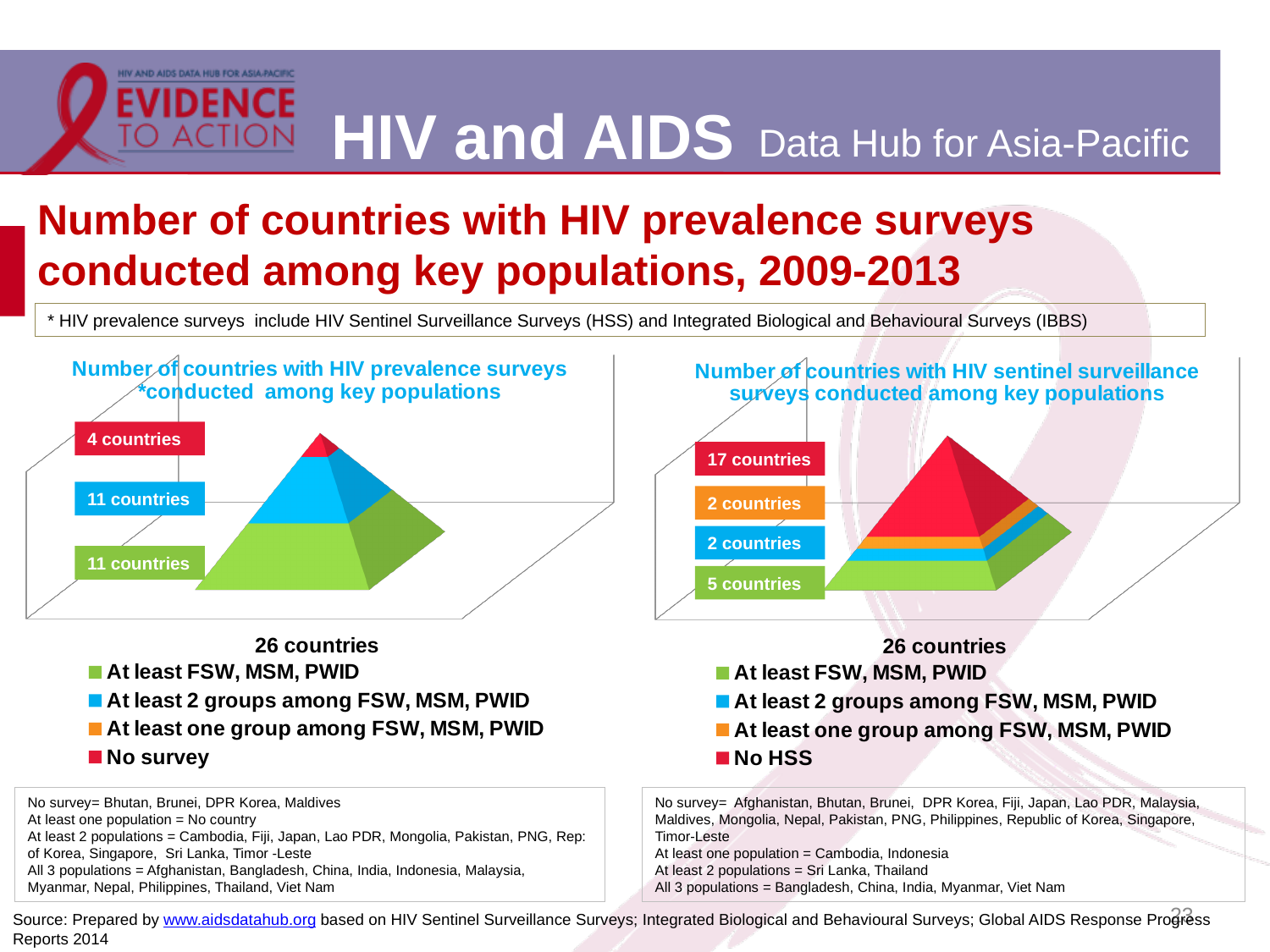
In the left chart (HIV prevalence surveys), which category has the smallest number of countries among those labelled? No survey What is the total number of countries shown in the left chart (HIV prevalence surveys)? 26 countries In the left chart (HIV prevalence surveys), how many countries have surveys for at least FSW, MSM, PWID? 11 countries In the right chart (HIV sentinel surveillance surveys), how many countries have surveys for at least one group among FSW, MSM, PWID? 2 countries In the left chart (HIV prevalence surveys), how many countries have no survey? 4 countries In the right chart (HIV sentinel surveillance surveys), what is the difference between the number of countries with no HSS and the number with surveys for at least FSW, MSM, PWID? 12 In the right chart (HIV sentinel surveillance surveys), how many countries have surveys for at least FSW, MSM, PWID? 5 countries In the right chart (HIV sentinel surveillance surveys), how many countries have no HSS? 17 countries How many entries does the legend of the right chart (HIV sentinel surveillance surveys) list? 4 Which is larger: the number of countries with no survey in the left chart or the number with no HSS in the right chart? No HSS in the right chart In the right chart (HIV sentinel surveillance surveys), which category has the largest number of countries? No HSS What kind of chart is used on this slide? Pyramid chart